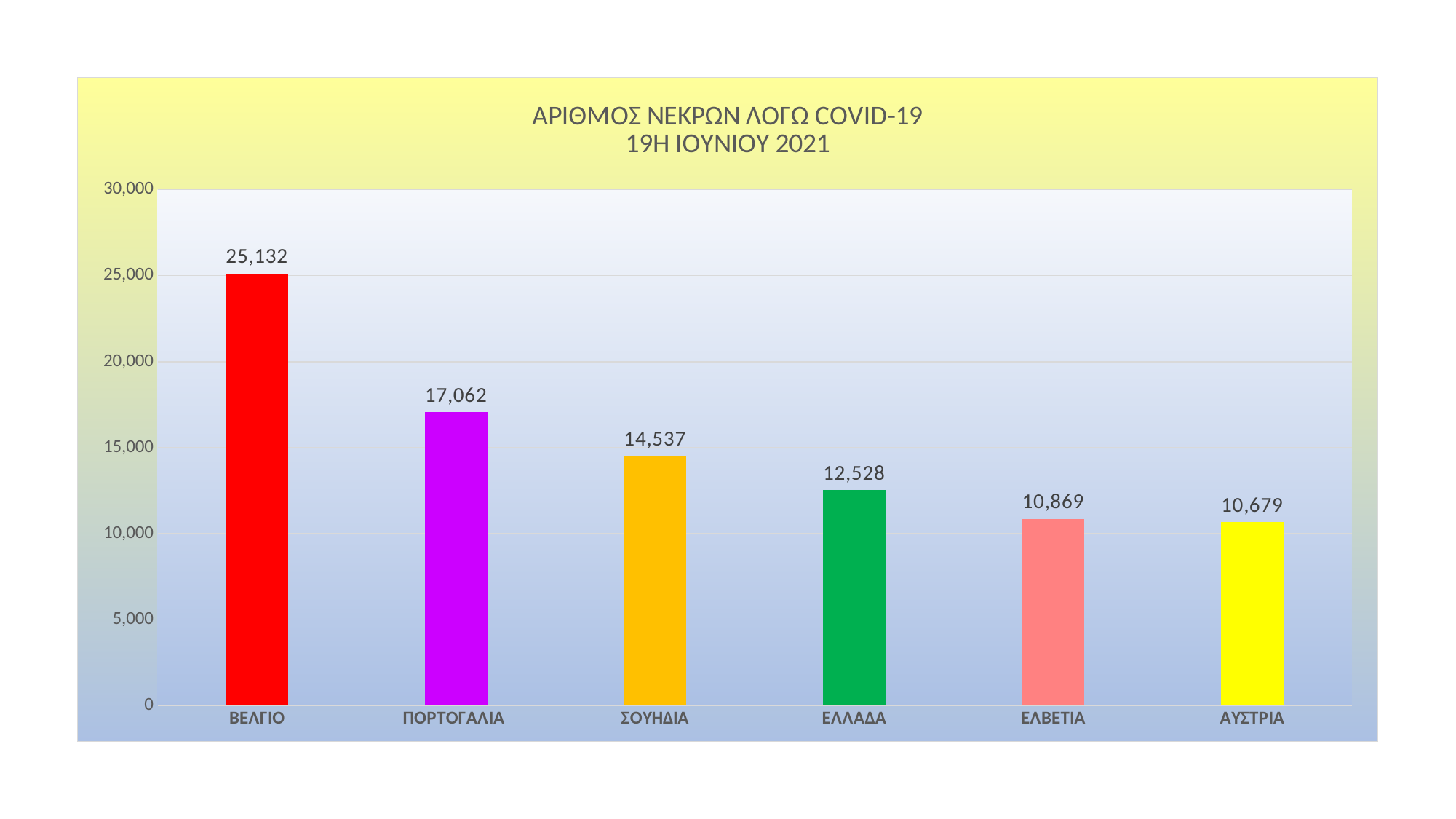
Is the value for ΕΛΒΕΤΙΑ greater or less than 15,000? less What is the value for ΕΛΛΑΔΑ? 12,528 What kind of chart is shown on the slide? bar chart Which country has the lowest value? ΑΥΣΤΡΙΑ What is the value for ΑΥΣΤΡΙΑ? 10,679 What is the difference between the values for ΒΕΛΓΙΟ and ΠΟΡΤΟΓΑΛΙΑ? 8,070 Which is larger, the value for ΠΟΡΤΟΓΑΛΙΑ or the value for ΣΟΥΗΔΙΑ? ΠΟΡΤΟΓΑΛΙΑ What colour is the bar for ΕΛΛΑΔΑ? green What is the value for ΒΕΛΓΙΟ? 25,132 Which country has the highest value? ΒΕΛΓΙΟ What is the difference between the values for ΣΟΥΗΔΙΑ and ΕΛΛΑΔΑ? 2,009 How many countries are shown on the chart? 6